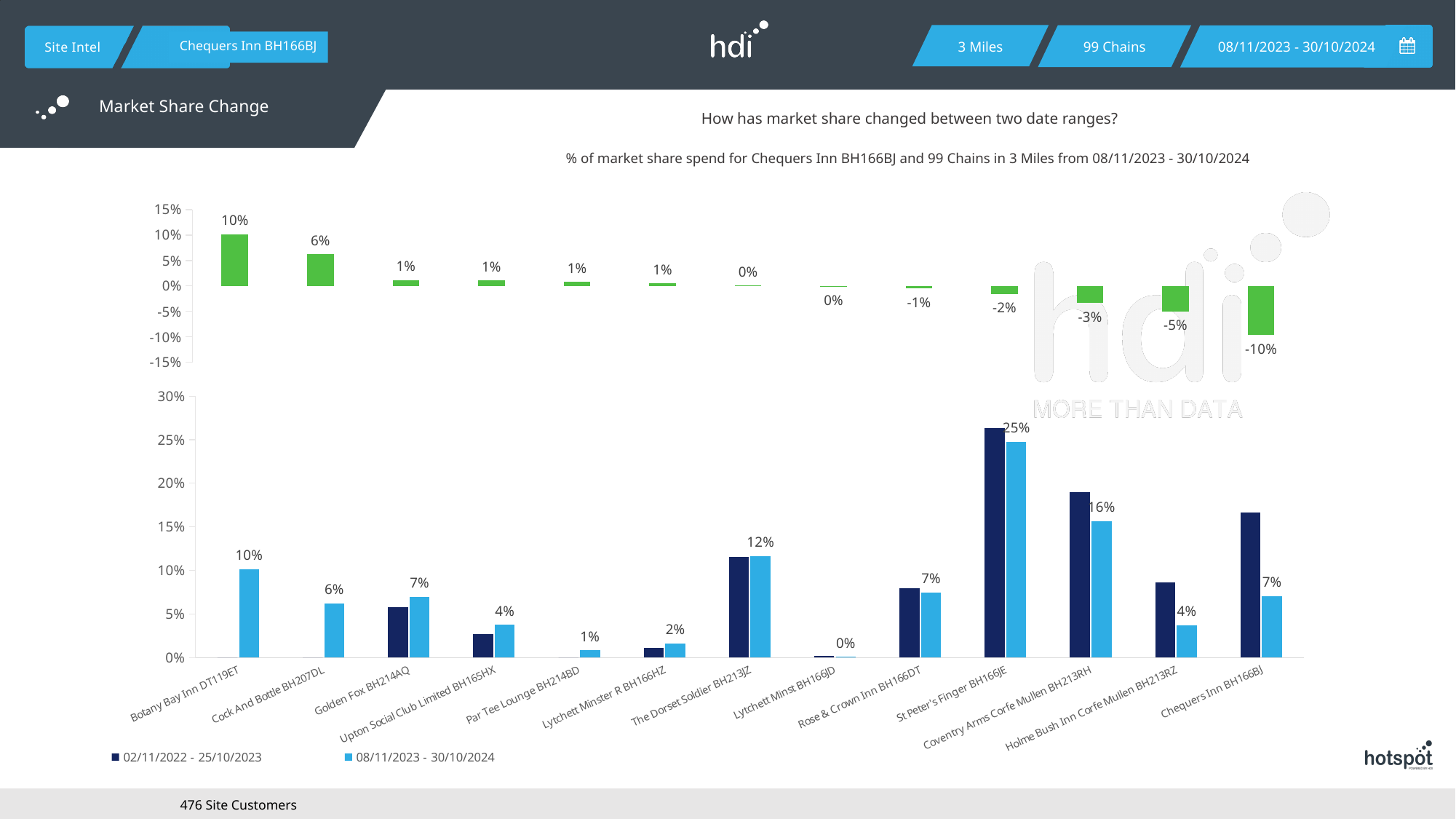
In the top chart, what is the market share change for Chequers Inn BH166BJ? -10% In the top chart, which venue has the highest market share change? Botany Bay Inn DT119ET In the top chart, what is the difference between the change for Cock And Bottle BH207DL and Holme Bush Inn Corfe Mullen BH213RZ? 11% In the bottom chart, what is the value for St Peter's Finger BH166JE in the 08/11/2023 - 30/10/2024 series? 25% In the bottom chart, is the 02/11/2022 - 25/10/2023 value for Chequers Inn BH166BJ greater or less than 15%? greater In the bottom chart, which venue has the highest value in the 08/11/2023 - 30/10/2024 series? St Peter's Finger BH166JE In the top chart, what is the market share change for Botany Bay Inn DT119ET? 10% How many venues are shown on the x axis of the bottom chart? 13 How many series does the legend of the bottom chart list? 2 In the bottom chart, what is the value for The Dorset Soldier BH213JZ in the 08/11/2023 - 30/10/2024 series? 12% In the bottom chart, which is larger for Coventry Arms Corfe Mullen BH213RH: the 02/11/2022 - 25/10/2023 value or the 08/11/2023 - 30/10/2024 value? 02/11/2022 - 25/10/2023 In the top chart, which venue has the lowest market share change? Chequers Inn BH166BJ